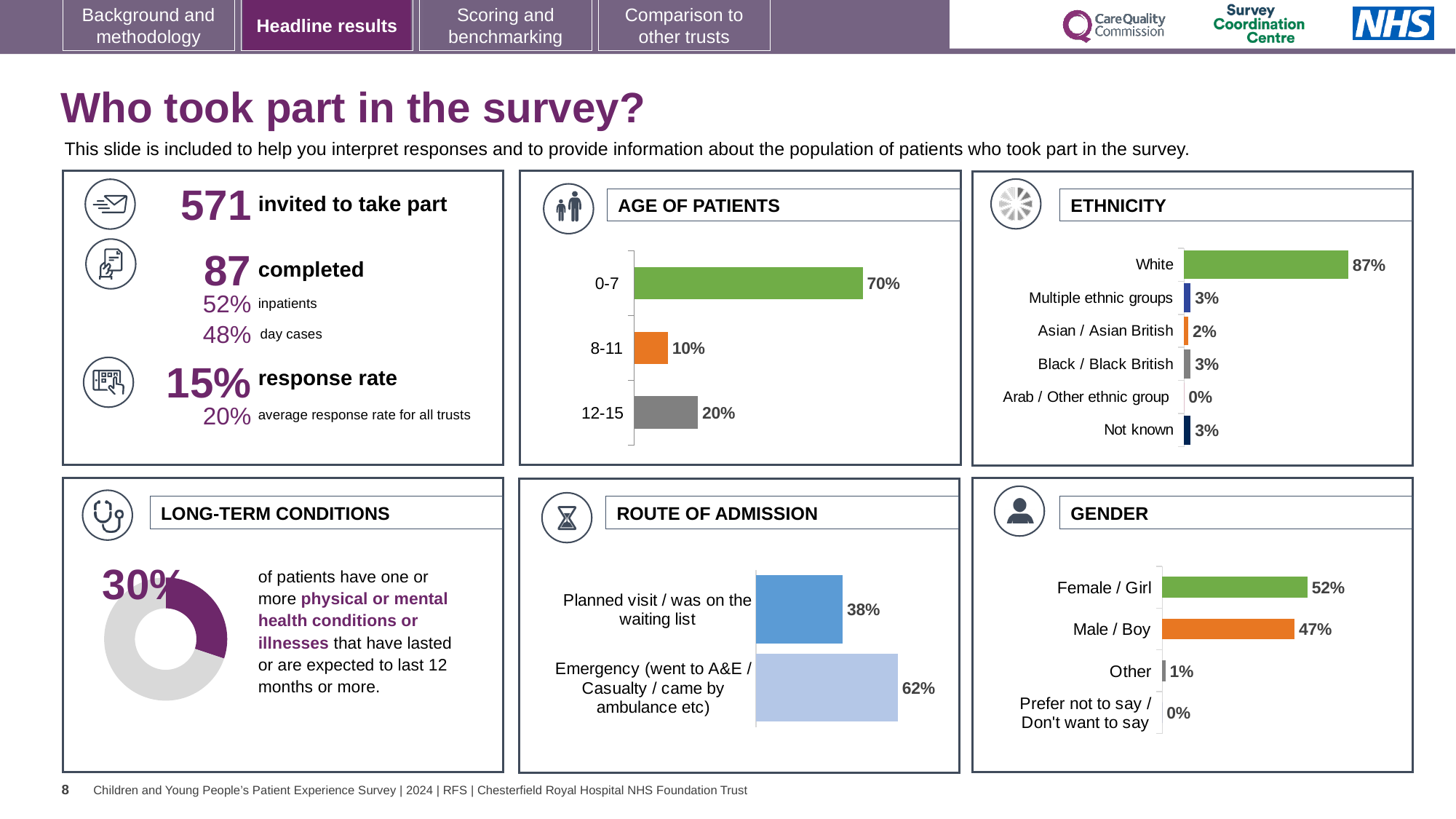
In the AGE OF PATIENTS chart, what is the difference between the 0-7 and 12-15 percentages? 50% What kind of chart is used in the LONG-TERM CONDITIONS panel? Doughnut chart In the ROUTE OF ADMISSION chart, what percentage of patients came via Emergency (went to A&E / Casualty / came by ambulance etc)? 62% In the ETHNICITY chart, how many ethnicity categories are shown? 6 In the GENDER chart, which category has the highest percentage? Female / Girl In the AGE OF PATIENTS chart, which age group has the lowest percentage? 8-11 In the ETHNICITY chart, what percentage of patients were White? 87% In the GENDER chart, what is the difference between the Female / Girl and Male / Boy percentages? 5% In the GENDER chart, what percentage of patients were Male / Boy? 47% In the AGE OF PATIENTS chart, what percentage of patients were aged 0-7? 70% In the ROUTE OF ADMISSION chart, which route has the larger value: Planned visit / was on the waiting list or Emergency? Emergency (went to A&E / Casualty / came by ambulance etc) In the ETHNICITY chart, what is the value for Asian / Asian British? 2%